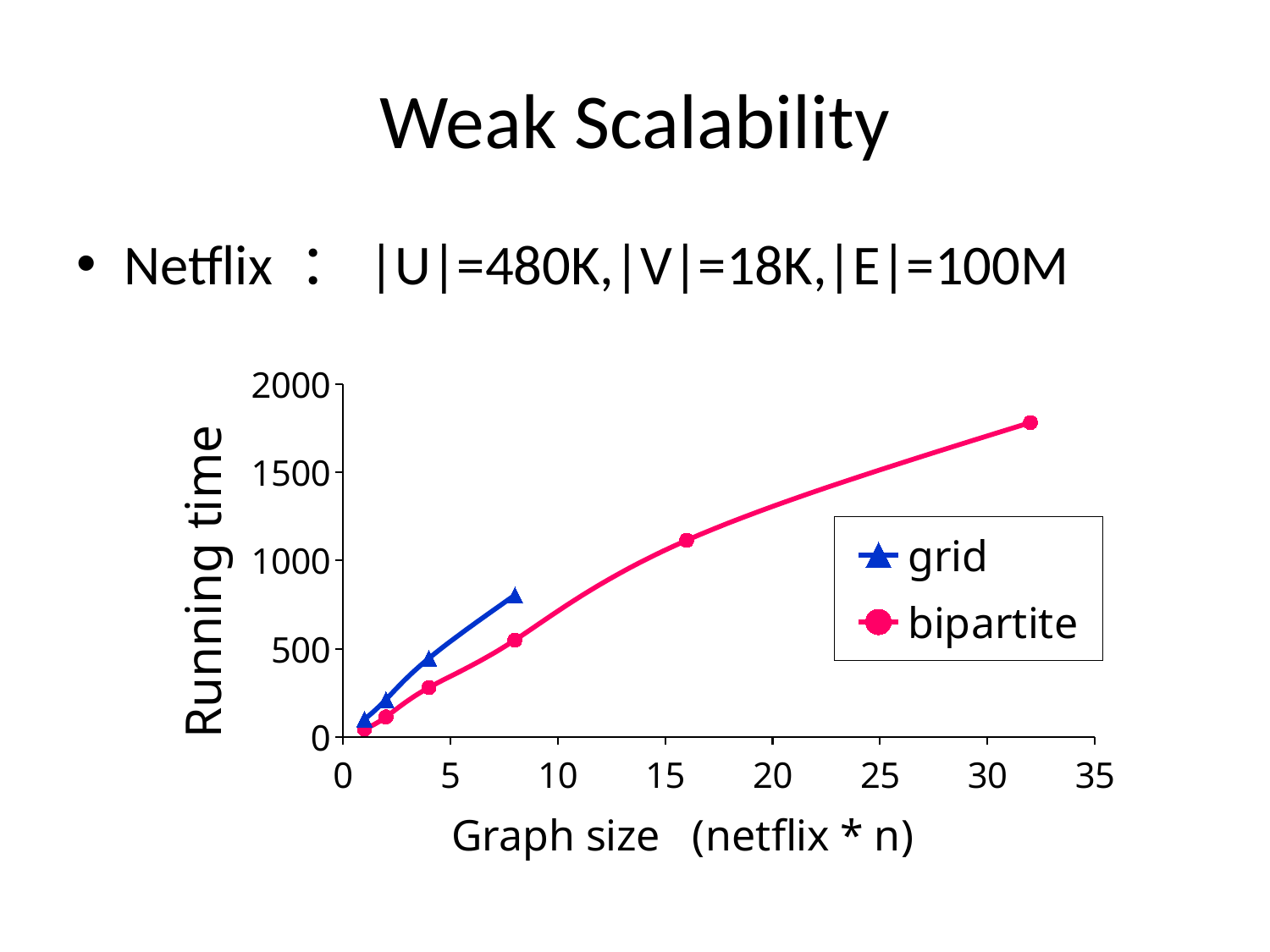
At graph size 8, which series has the higher running time, grid or bipartite? grid How many data points are plotted for the grid series? 4 Is the running time for the bipartite series at graph size 32 greater or less than 1500? greater What is the label of the x axis? Graph size (netflix * n) How many series does the legend list? 2 Is the running time for the bipartite series at graph size 16 greater or less than 1000? greater Which series reaches the highest running time on the chart? bipartite Is the running time for the grid series at graph size 8 greater or less than 1000? less Does the running time for the bipartite series rise or fall as graph size increases? rise What kind of chart is shown on the slide? line chart How many data points are plotted for the bipartite series? 6 What is the label of the y axis? Running time